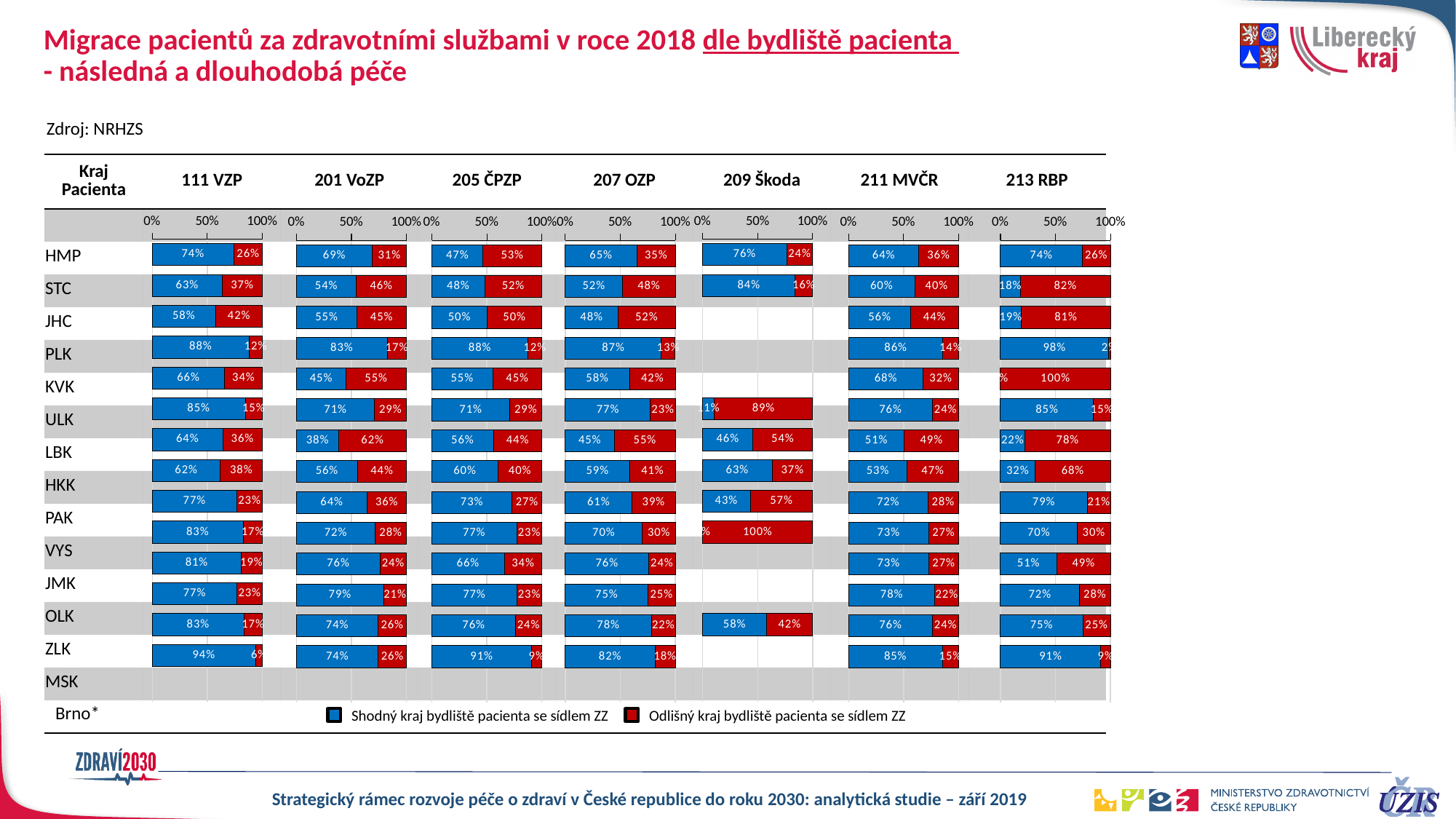
What does the blue legend entry represent? Shodný kraj bydliště pacienta se sídlem ZZ In the 209 Škoda chart, what is the blue (same region) value for STC? 84% In the 213 RBP chart, what is the blue (same region) value for PLK? 98% How many insurer charts are shown side by side on the slide? 7 In the 111 VZP chart, what is the total of the HMP stacked bar? 100% In the 213 RBP chart, what is the red (different region) value for STC? 82% What kind of chart is used for each insurer column on the slide? Stacked bar chart In the 111 VZP chart, what is the difference between the blue and red values for HMP? 48 percentage points How many series does the legend list? 2 In the 111 VZP chart, what share of HMP patients used services in the same region as their residence (blue segment)? 74% In the 205 ČPZP chart, what is the red (different region) value for HMP? 53% For HMP, which chart shows a larger blue (same region) value: 201 VoZP or 205 ČPZP? 201 VoZP